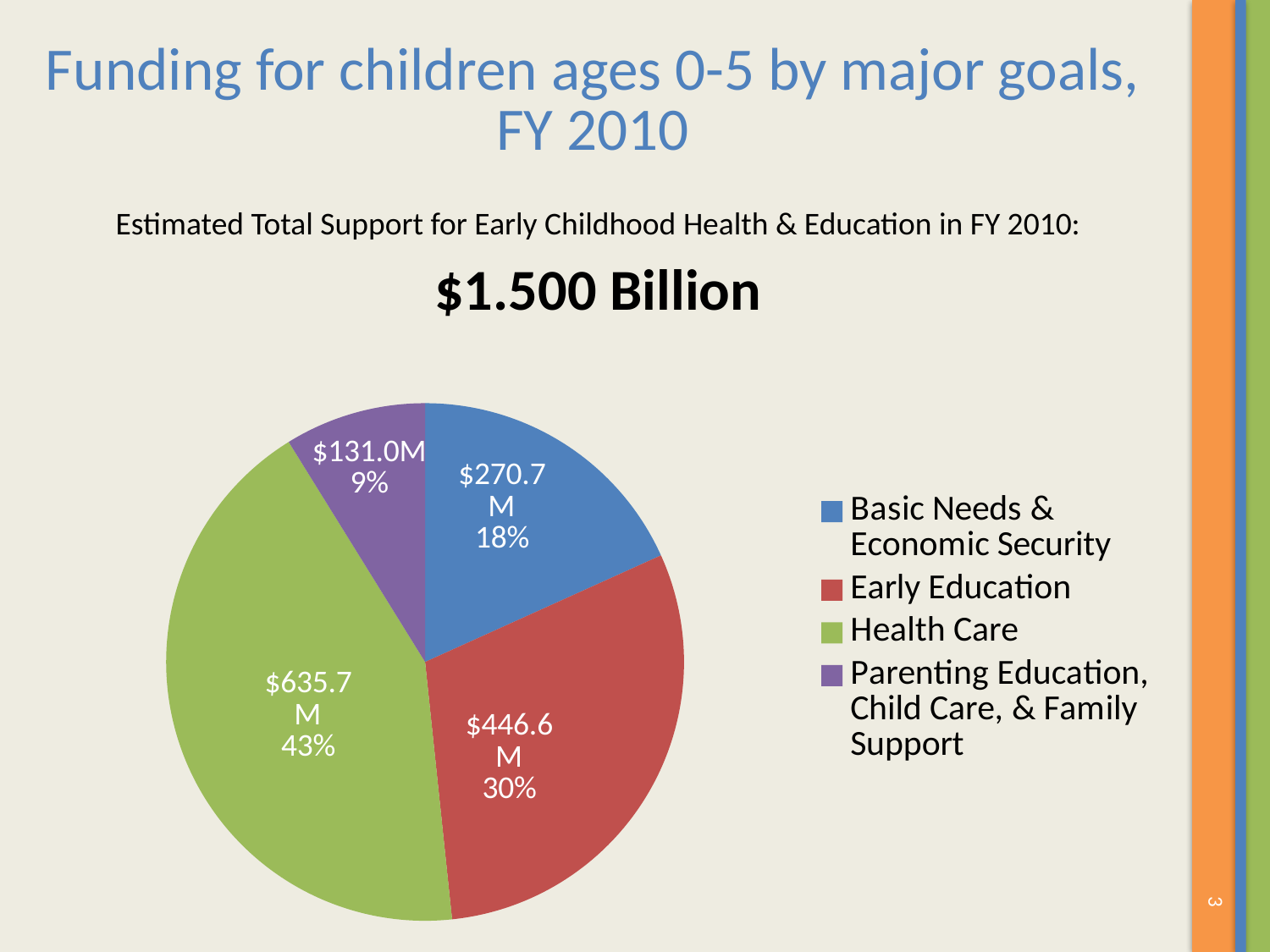
What is the funding amount for Basic Needs & Economic Security? $270.7M What is the funding amount for Early Education? $446.6M How many slices does the pie chart have? 4 What type of chart is shown on the slide? pie chart How many entries does the legend list? 4 What share of the pie does Health Care represent? 43% Which category receives the most funding? Health Care What share of the pie does Parenting Education, Child Care, & Family Support represent? 9% What is the funding amount for Health Care? $635.7M What is the difference in funding between Health Care and Early Education? $189.1M What is the funding amount for Parenting Education, Child Care, & Family Support? $131.0M Which category receives the least funding? Parenting Education, Child Care, & Family Support